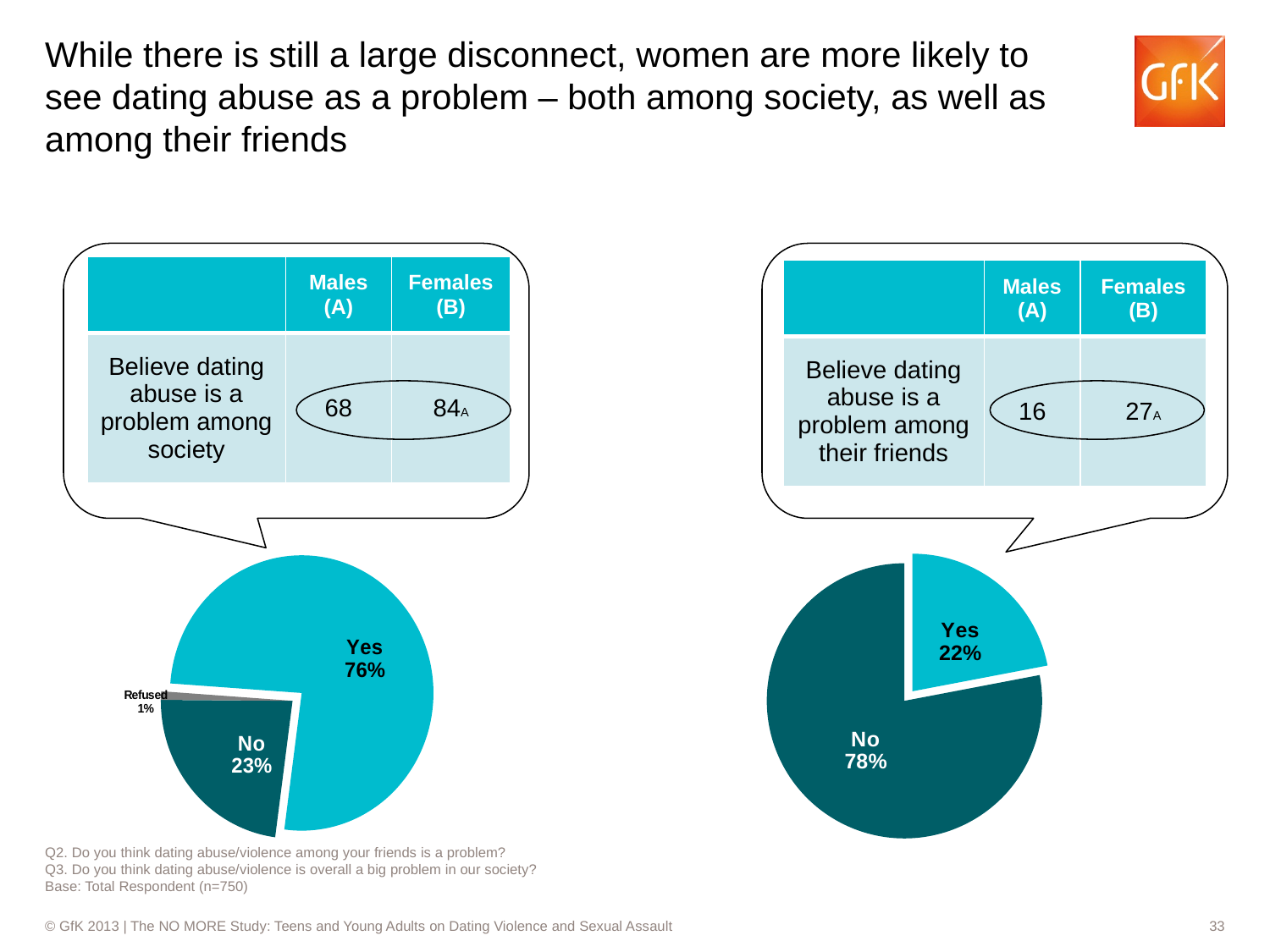
In the right pie chart (dating abuse as a problem among their friends), what is the difference between the No and Yes shares? 56% In the left pie chart (dating abuse as a problem among society), what share of respondents Refused? 1% In the left pie chart (dating abuse as a problem among society), which response has the smallest slice? Refused In the right pie chart (dating abuse as a problem among their friends), what share of respondents answered Yes? 22% What type of chart is used on the right side of the slide to show responses about dating abuse among their friends? Pie chart In the left pie chart (dating abuse as a problem among society), what share of respondents answered No? 23% How many slices does the left pie chart (dating abuse as a problem among society) have? 3 In the right pie chart (dating abuse as a problem among their friends), which response has the largest slice? No In the right pie chart (dating abuse as a problem among their friends), what share of respondents answered No? 78% In the left pie chart (dating abuse as a problem among society), what is the difference between the Yes and No shares? 53% In the left pie chart (dating abuse as a problem among society), what share of respondents answered Yes? 76% In the left pie chart (dating abuse as a problem among society), which response has the largest slice? Yes